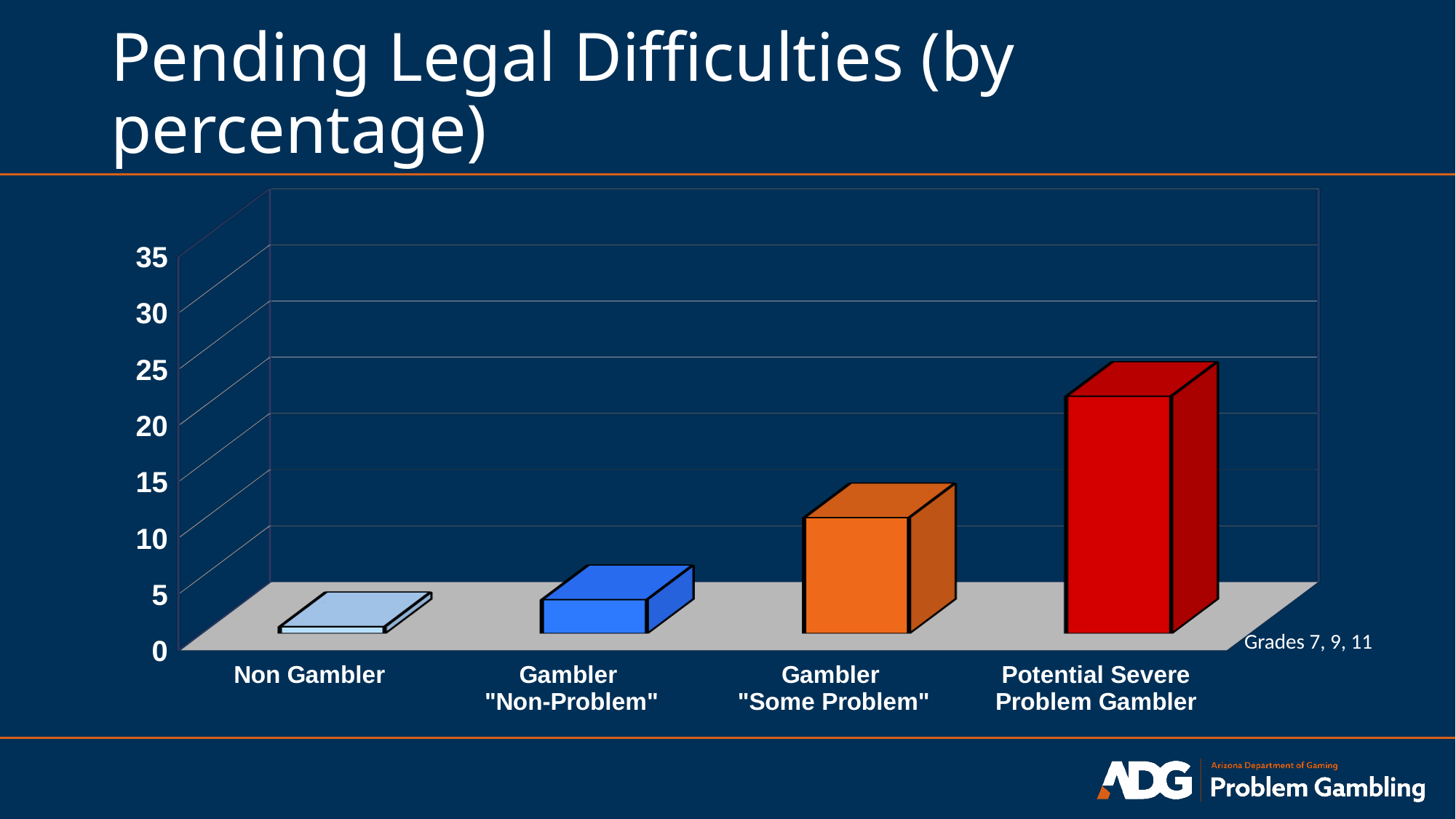
Is the value for Potential Severe Problem Gambler greater or less than 15? greater Which is larger, the value for Gambler "Some Problem" or the value for Gambler "Non-Problem"? Gambler "Some Problem" Which category has the lowest value? Non Gambler Which is larger, the value for Potential Severe Problem Gambler or the value for Gambler "Some Problem"? Potential Severe Problem Gambler Which category has the highest value? Potential Severe Problem Gambler Is the value for Gambler "Non-Problem" greater or less than 10? less Do the values rise or fall moving from left to right across the categories? rise Is the value for Non Gambler greater or less than 5? less What kind of chart is shown on the slide? bar chart What is the title of the chart on the slide? Pending Legal Difficulties (by percentage) How many categories are plotted on the chart? 4